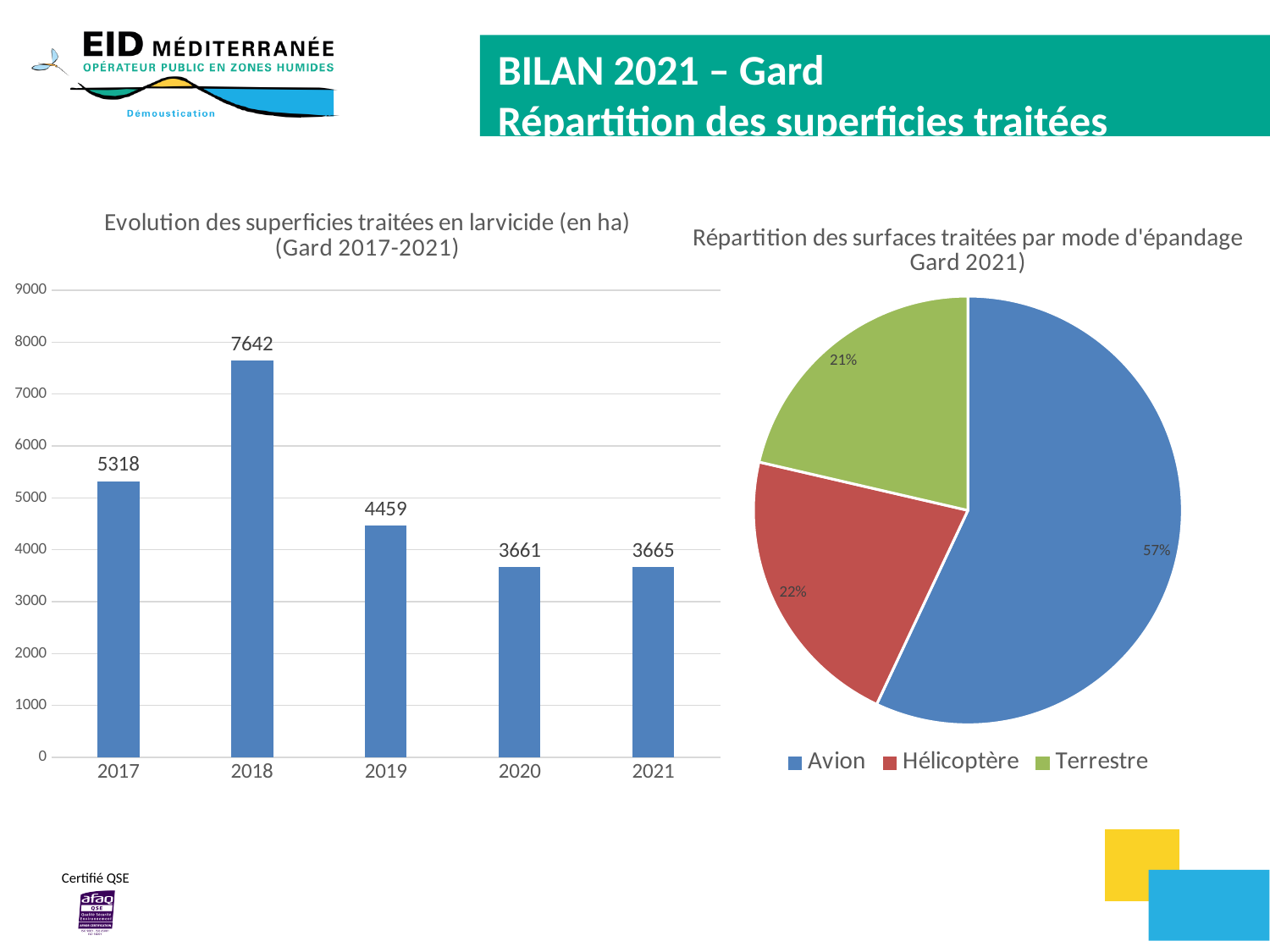
In the pie chart 'Répartition des surfaces traitées par mode d'épandage', what share does Avion have? 57% In the pie chart 'Répartition des surfaces traitées par mode d'épandage', what share does Terrestre have? 21% What kind of chart is the left chart, 'Evolution des superficies traitées en larvicide (en ha)'? Bar chart In the pie chart 'Répartition des surfaces traitées par mode d'épandage', which mode has the largest share? Avion In the bar chart 'Evolution des superficies traitées en larvicide (en ha)', how many years are shown? 5 In the bar chart 'Evolution des superficies traitées en larvicide (en ha)', which year has the lowest value? 2020 In the bar chart 'Evolution des superficies traitées en larvicide (en ha)', what is the value for 2020? 3661 In the bar chart 'Evolution des superficies traitées en larvicide (en ha)', what is the difference between the values for 2018 and 2017? 2324 In the bar chart 'Evolution des superficies traitées en larvicide (en ha)', which is larger, the value for 2017 or the value for 2019? 2017 How many entries does the legend of the pie chart 'Répartition des surfaces traitées par mode d'épandage' list? 3 In the bar chart 'Evolution des superficies traitées en larvicide (en ha)', what is the value for 2018? 7642 In the bar chart 'Evolution des superficies traitées en larvicide (en ha)', which year has the highest value? 2018